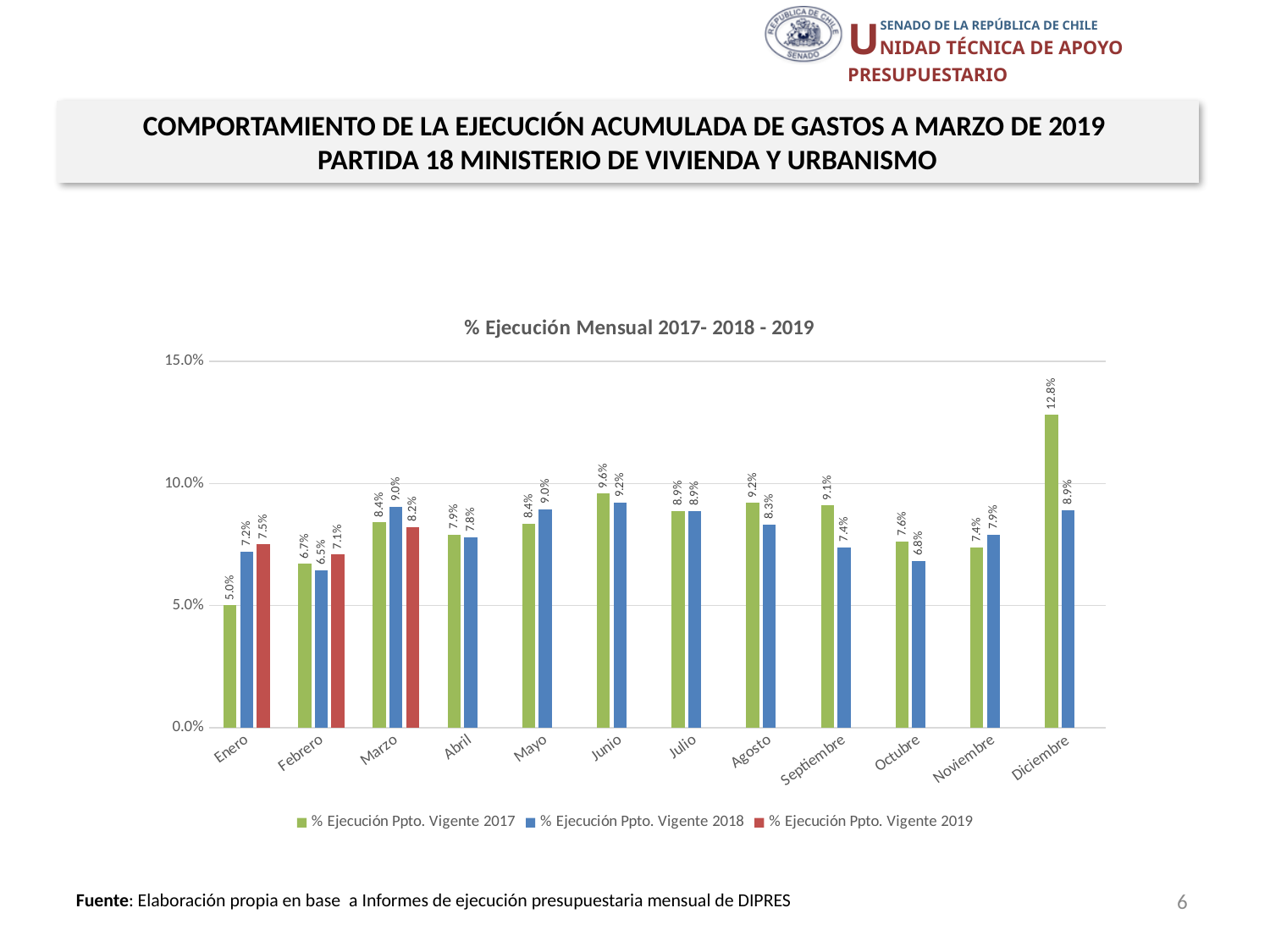
What kind of chart is shown on the slide? Bar chart What is the value for % Ejecución Ppto. Vigente 2017 in Diciembre? 12.8% What is the difference between the 2018 and 2017 values in Enero? 2.2% In Agosto, which series is larger: % Ejecución Ppto. Vigente 2017 or % Ejecución Ppto. Vigente 2018? % Ejecución Ppto. Vigente 2017 Is the value for % Ejecución Ppto. Vigente 2017 in Diciembre greater or less than 10.0%? greater Which month has the highest value for % Ejecución Ppto. Vigente 2017? Diciembre How many months are shown on the x axis? 12 What is the value for % Ejecución Ppto. Vigente 2018 in Septiembre? 7.4% How many series does the legend list? 3 What is the title of the chart? % Ejecución Mensual 2017- 2018 - 2019 What is the value for % Ejecución Ppto. Vigente 2019 in Marzo? 8.2% Which month has the lowest value for % Ejecución Ppto. Vigente 2017? Enero